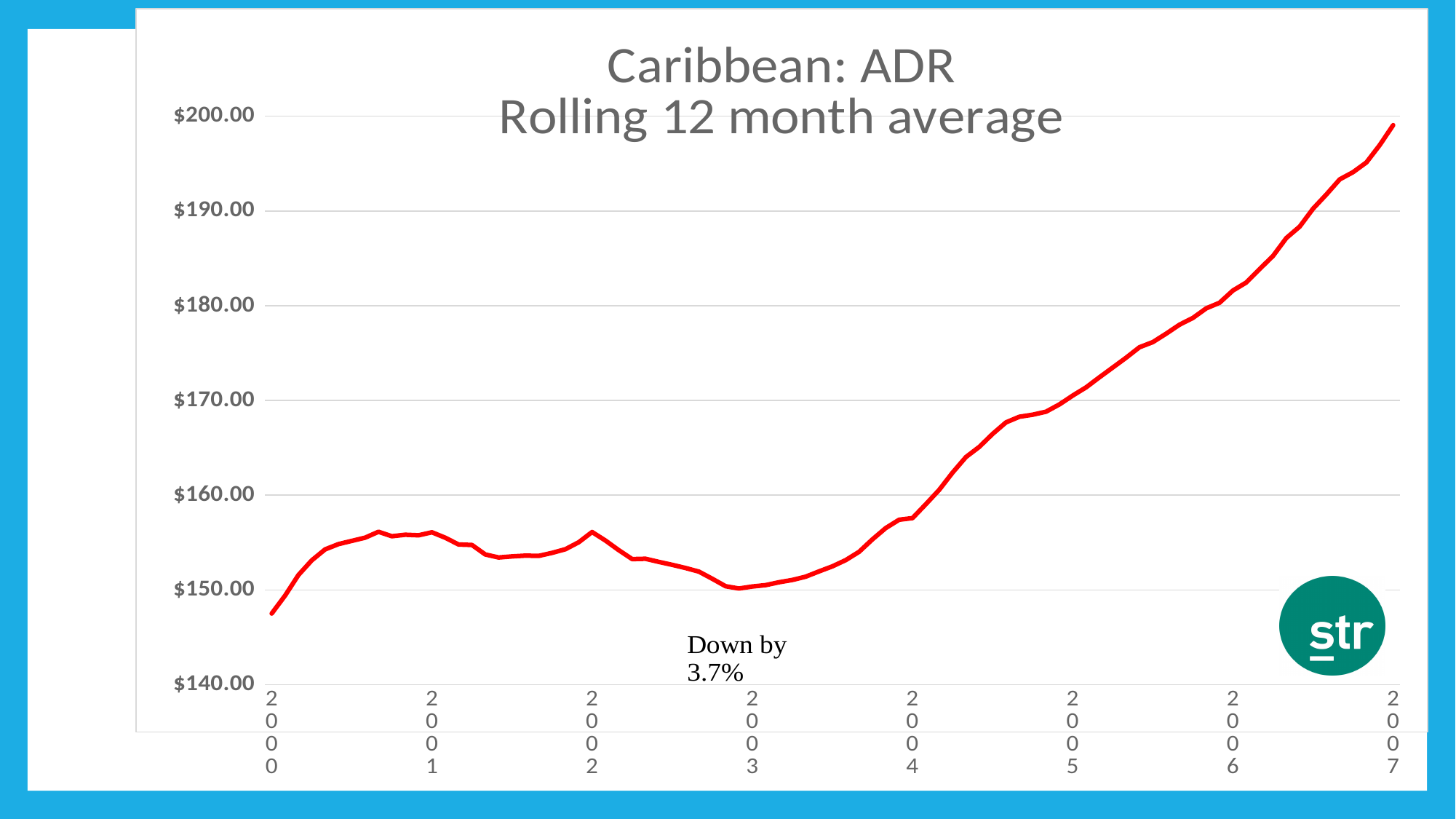
Overall, does the ADR rise or fall from 2000 to 2007? rise Is the value at 2005 greater or less than $160.00? greater In which year shown on the x axis does the line reach its highest value? 2007 Is the value at 2004 greater or less than $160.00? less In which year shown on the x axis does the line have its lowest value? 2000 What kind of chart is shown on the slide? line chart Which is larger, the value at 2005 or the value at 2004? 2005 What does the annotation near the 2003 point on the chart say? Down by 3.7% What is the title of the chart? Caribbean: ADR Rolling 12 month average Is the value at 2000 greater or less than $150.00? less How many year labels are shown on the x axis? 8